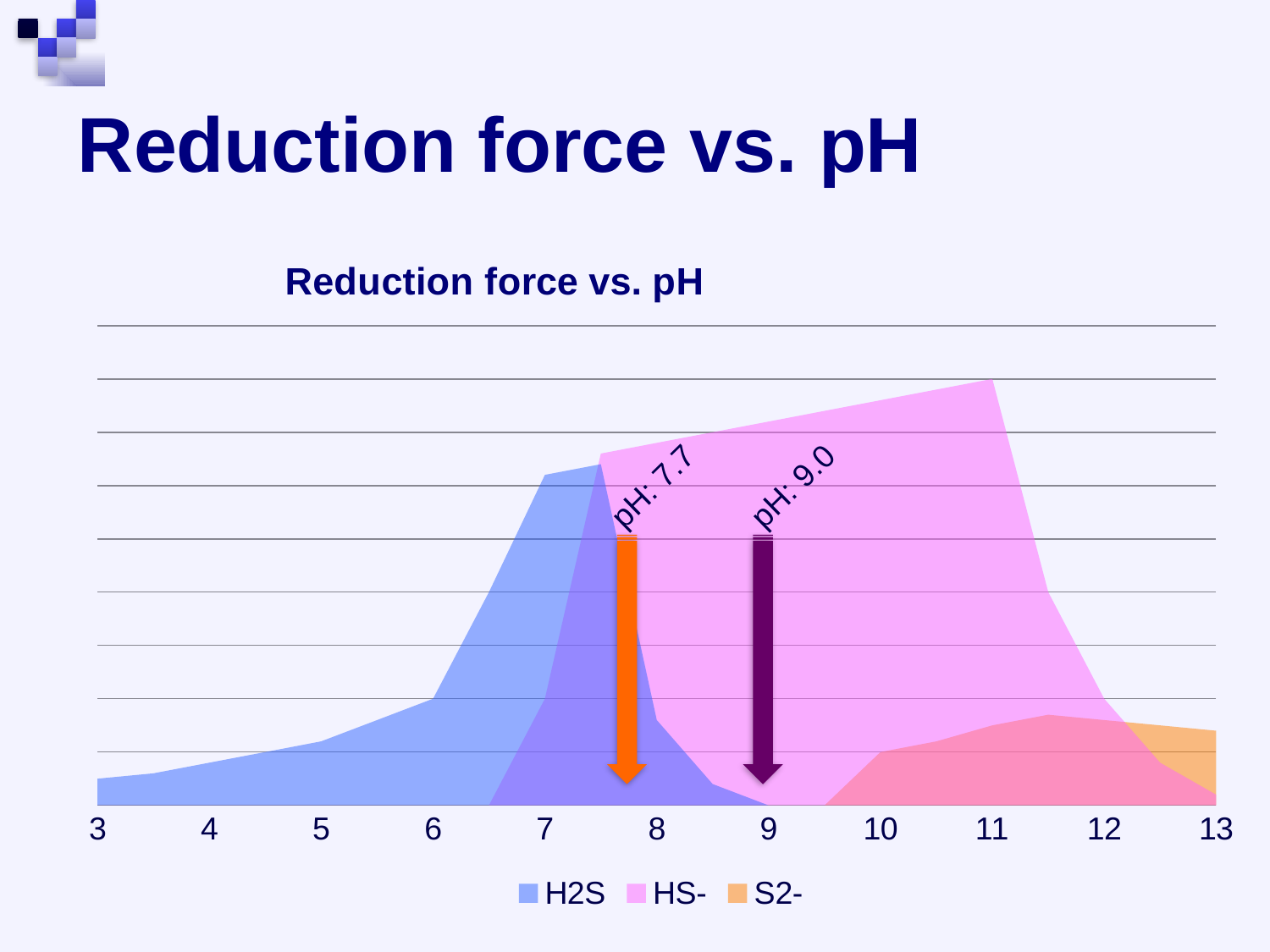
Which series reaches the highest peak on the chart? HS- What two pH values are marked by the arrows on the chart? pH: 7.7 and pH: 9.0 What is the highest pH value shown on the x axis? 13 How many series does the legend list? 3 What is the lowest pH value shown on the x axis? 3 What are the series names listed in the legend? H2S, HS-, S2- What is the title of the chart? Reduction force vs. pH How many pH values are labelled along the x axis? 11 Which series peaks higher, H2S or HS-? HS- Does the H2S series rise or fall as pH increases from 7 to 13? Fall What kind of chart is shown on the slide? Area chart